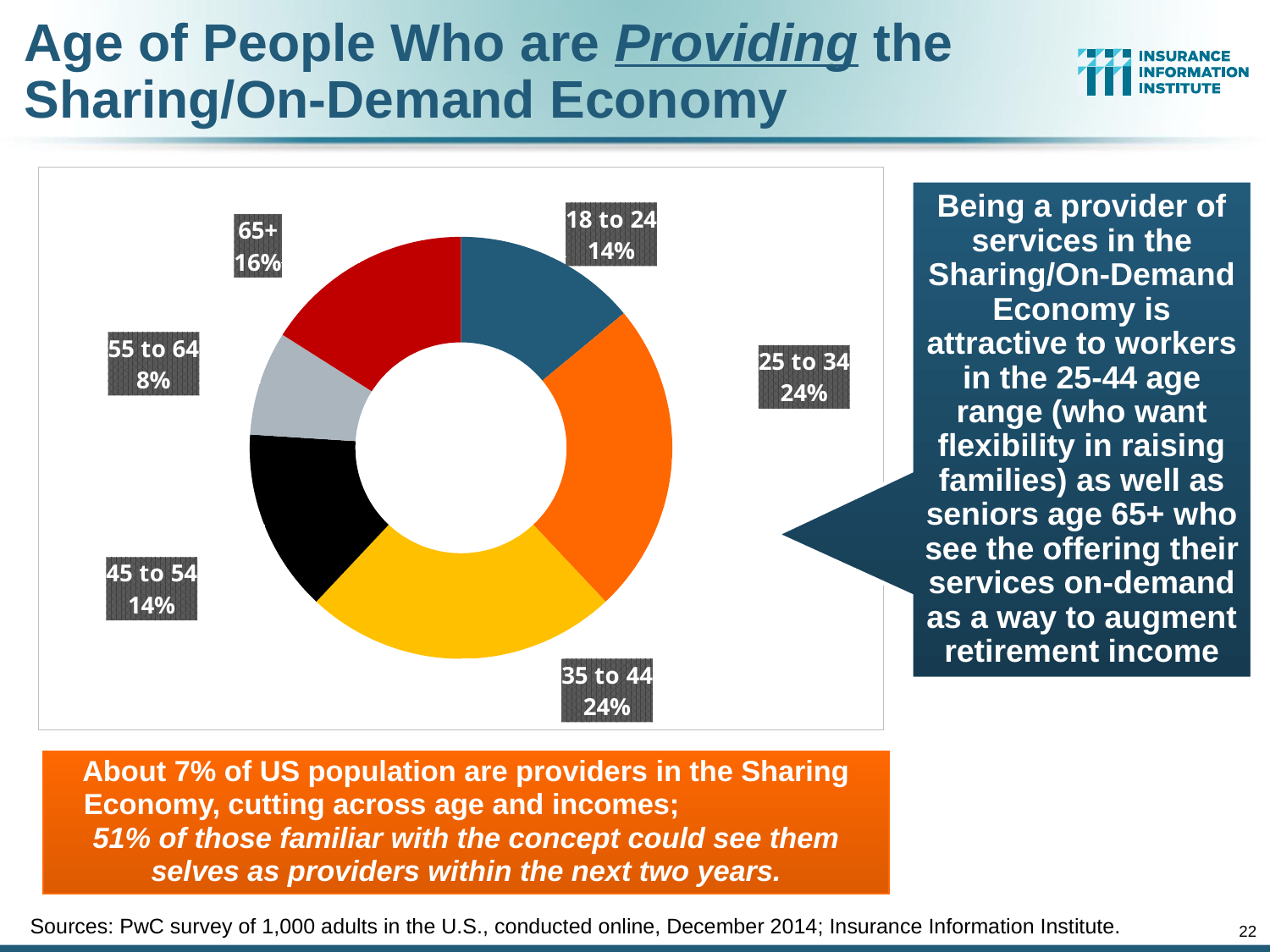
How many age groups are shown in the chart? 6 What colour is the slice for the 35 to 44 age group? Yellow Which is larger: the share for 65+ or the share for 45 to 54? 65+ Which two age groups share the largest slice of the chart? 25 to 34 and 35 to 44 What percentage of providers are in the 25 to 34 age group? 24% What is the combined share of providers aged 25 to 44? 48% What is the difference in percentage points between the 35 to 44 share and the 55 to 64 share? 16 Which age group has the smallest share of providers? 55 to 64 What share of providers in the Sharing/On-Demand Economy are aged 18 to 24? 14% What share of providers are aged 55 to 64? 8% What percentage of providers are aged 65+? 16% What type of chart is used to show the age of providers? Pie chart (donut)